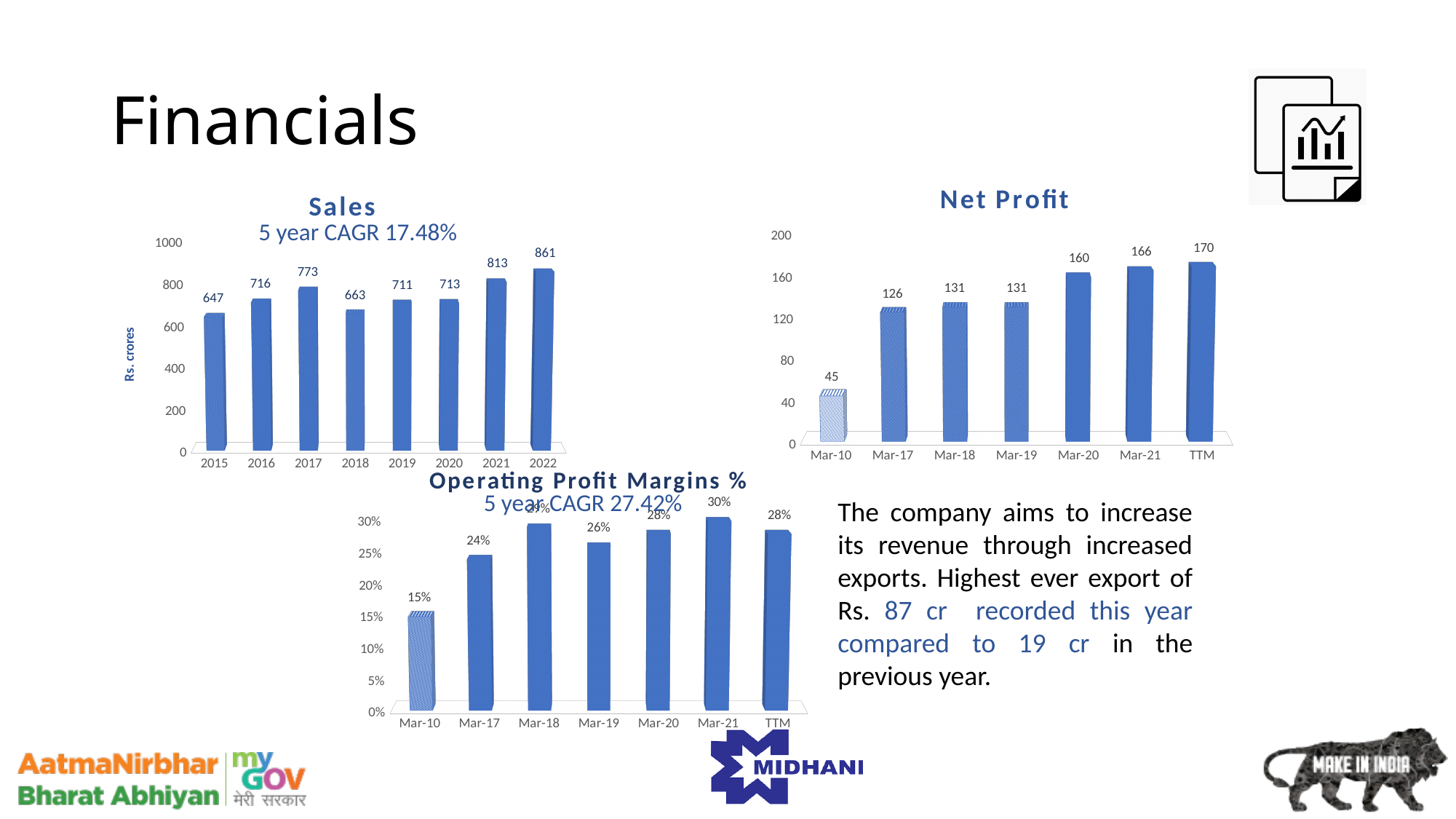
What 5 year CAGR is stated under the Sales chart title? 17.48% In the Net Profit chart, what is the net profit for Mar-20? 160 In the Sales chart, which year had the lowest sales? 2015 In the Operating Profit Margins % chart, what is the margin for Mar-21? 30% In the Net Profit chart, which is larger: net profit in Mar-17 or Mar-20? Mar-20 In the Sales chart, what is the difference between sales in 2021 and 2018? 150 In the Net Profit chart, which period has the highest net profit? TTM In the Operating Profit Margins % chart, which period has the lowest margin? Mar-10 In the Sales chart, how many years are plotted? 8 In the Sales chart, what was the sales value for 2022? 861 In the Net Profit chart, what is the difference between net profit in Mar-21 and Mar-10? 121 What type of chart is the Net Profit chart? Bar chart